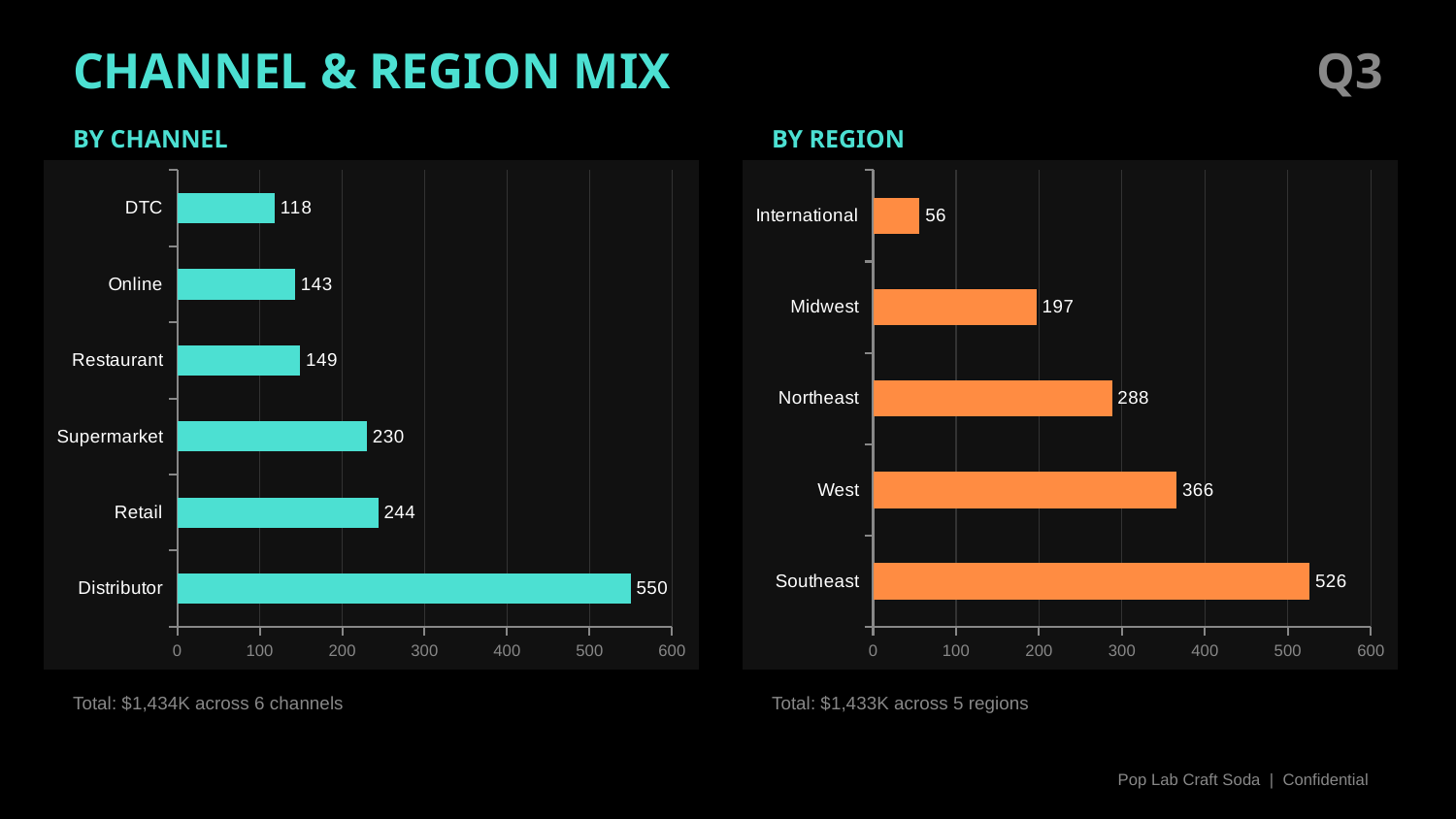
In the BY REGION chart, what is the difference between West and Midwest? 169 How many regions are shown in the BY REGION chart? 5 In the BY REGION chart, is the value for Southeast greater or less than 500? greater What colour are the bars in the BY CHANNEL chart? Teal In the BY REGION chart, what is the value for Northeast? 288 In the BY CHANNEL chart, which is larger, Online or Supermarket? Supermarket In the BY REGION chart, which region has the lowest value? International In the BY CHANNEL chart, what is the difference between Distributor and Retail? 306 In the BY CHANNEL chart, which channel has the highest value? Distributor How many channels are shown in the BY CHANNEL chart? 6 What kind of chart is the BY REGION chart? Bar chart In the BY CHANNEL chart, what is the value for Supermarket? 230